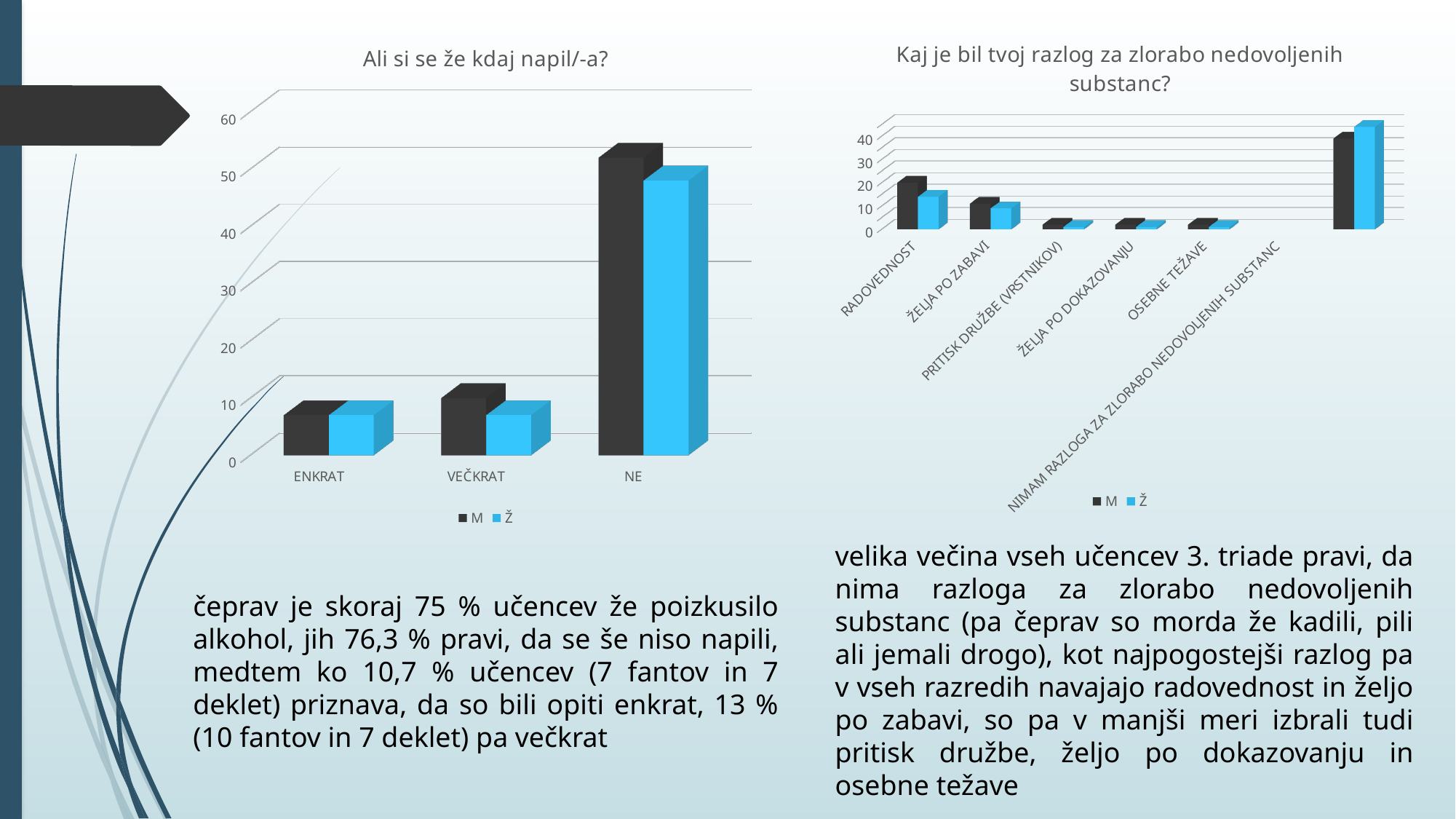
On the chart titled "Kaj je bil tvoj razlog za zlorabo nedovoljenih substanc?", what are the two legend entries? M and Ž On the chart titled "Kaj je bil tvoj razlog za zlorabo nedovoljenih substanc?", is the value for NIMAM RAZLOGA ZA ZLORABO NEDOVOLJENIH SUBSTANC in series Ž greater or less than 30? greater On the chart titled "Kaj je bil tvoj razlog za zlorabo nedovoljenih substanc?", is the value for RADOVEDNOST in series M greater or less than 30? less On the chart titled "Ali si se že kdaj napil/-a?", which category has the highest value for series M? NE On the chart titled "Ali si se že kdaj napil/-a?", how many categories are shown on the x axis? 3 On the chart titled "Kaj je bil tvoj razlog za zlorabo nedovoljenih substanc?", how many categories are shown on the x axis? 6 On the chart titled "Kaj je bil tvoj razlog za zlorabo nedovoljenih substanc?", which category has the highest value for series Ž? NIMAM RAZLOGA ZA ZLORABO NEDOVOLJENIH SUBSTANC On the chart titled "Ali si se že kdaj napil/-a?", is the value for ENKRAT in series M greater or less than 10? less On the chart titled "Ali si se že kdaj napil/-a?", for the category NE, which series has the larger value, M or Ž? M On the chart titled "Ali si se že kdaj napil/-a?", what kind of chart is shown? bar chart On the chart titled "Ali si se že kdaj napil/-a?", how many series does the legend list? 2